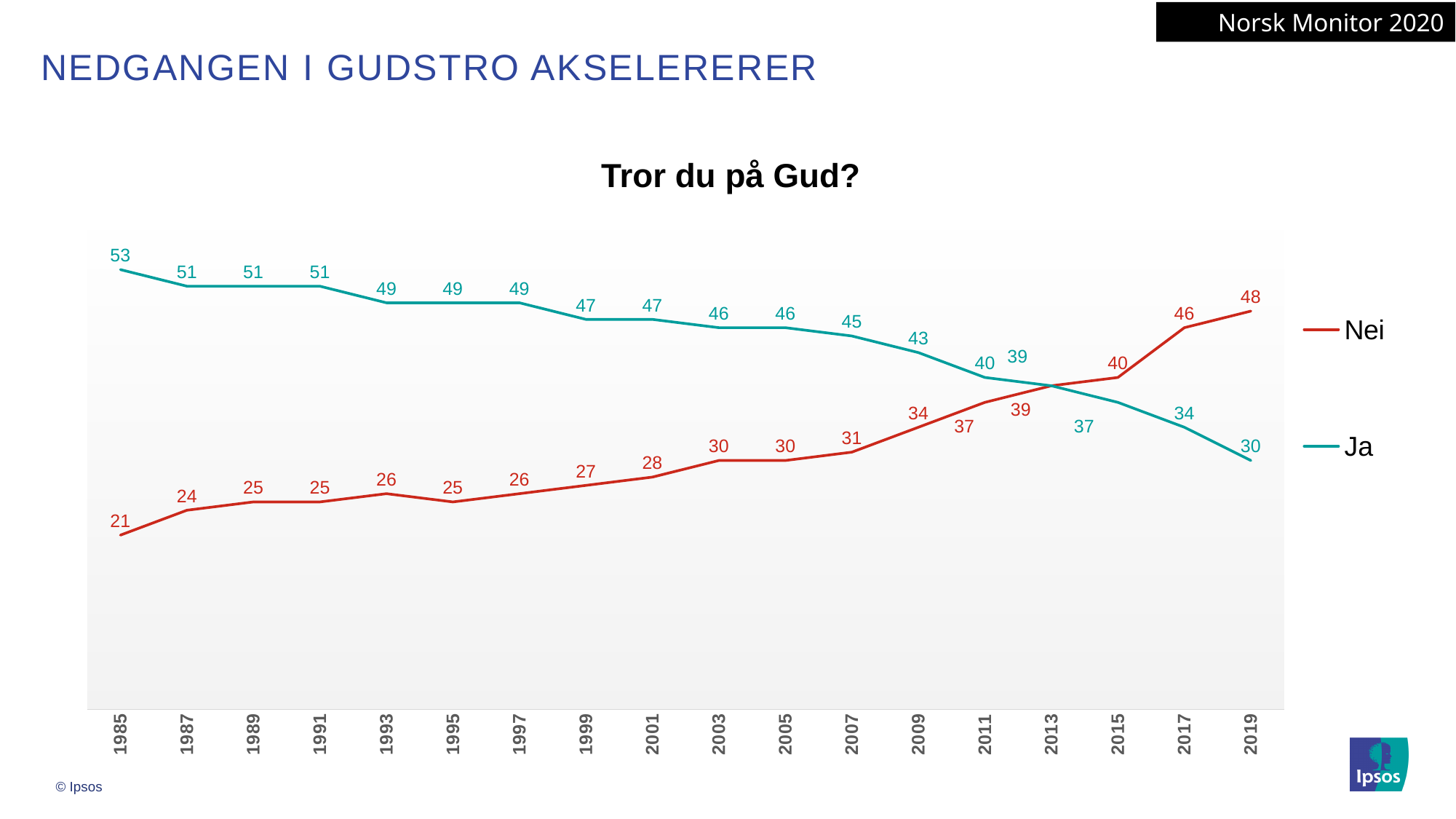
Which is larger in 2017, the Nei value or the Ja value? Nei In which year is the Nei series at its highest? 2019 What is the value for Ja in 1985? 53 Does the Ja series rise or fall from 1985 to 2019? fall In which year is the Ja series at its lowest? 2019 What is the difference between the Ja value in 1985 and the Ja value in 2019? 23 How many years are shown on the x axis? 18 What is the value for Nei in 2019? 48 What is the value for Nei in 2001? 28 How many series does the legend list? 2 What type of chart is shown on the slide? line chart What is the value for Ja in 2009? 43